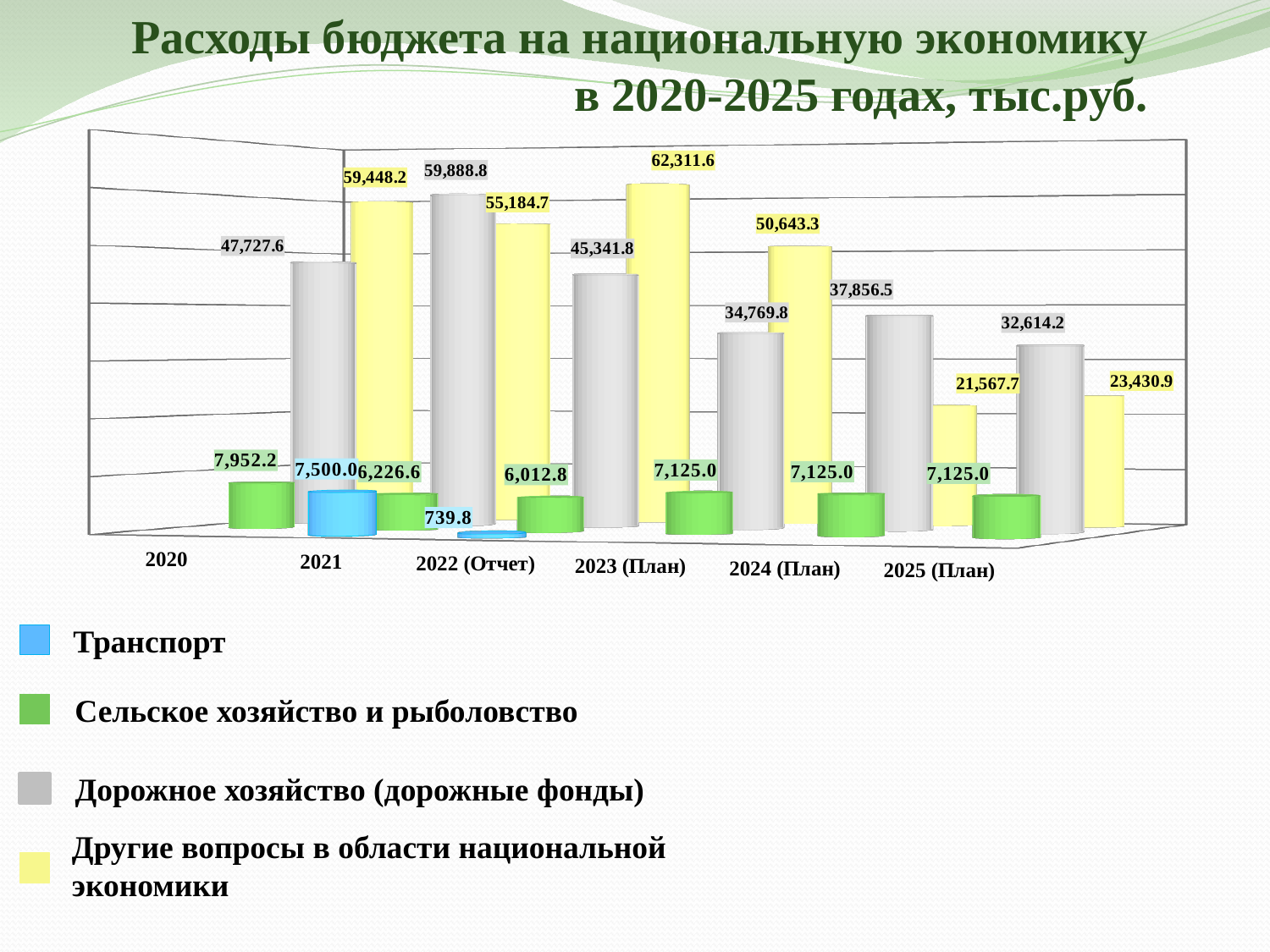
What is the difference between the Дорожное хозяйство (дорожные фонды) values in 2021 and 2020? 12,161.2 How many series does the legend list? 4 In which year is the value for Дорожное хозяйство (дорожные фонды) the highest? 2021 What type of chart is shown on the slide? bar chart What is the value for Сельское хозяйство и рыболовство in 2025 (План)? 7,125.0 What is the value for Транспорт in 2021? 7,500.0 What is the value for Другие вопросы в области национальной экономики in 2022 (Отчет)? 62,311.6 What is the value for Дорожное хозяйство (дорожные фонды) in 2020? 47,727.6 How many year categories are shown on the x axis? 6 Does the value for Другие вопросы в области национальной экономики rise or fall from 2022 (Отчет) to 2024 (План)? fall In which year is the value for Другие вопросы в области национальной экономики the lowest? 2024 (План) In 2023 (План), which is larger: Дорожное хозяйство (дорожные фонды) or Другие вопросы в области национальной экономики? Другие вопросы в области национальной экономики